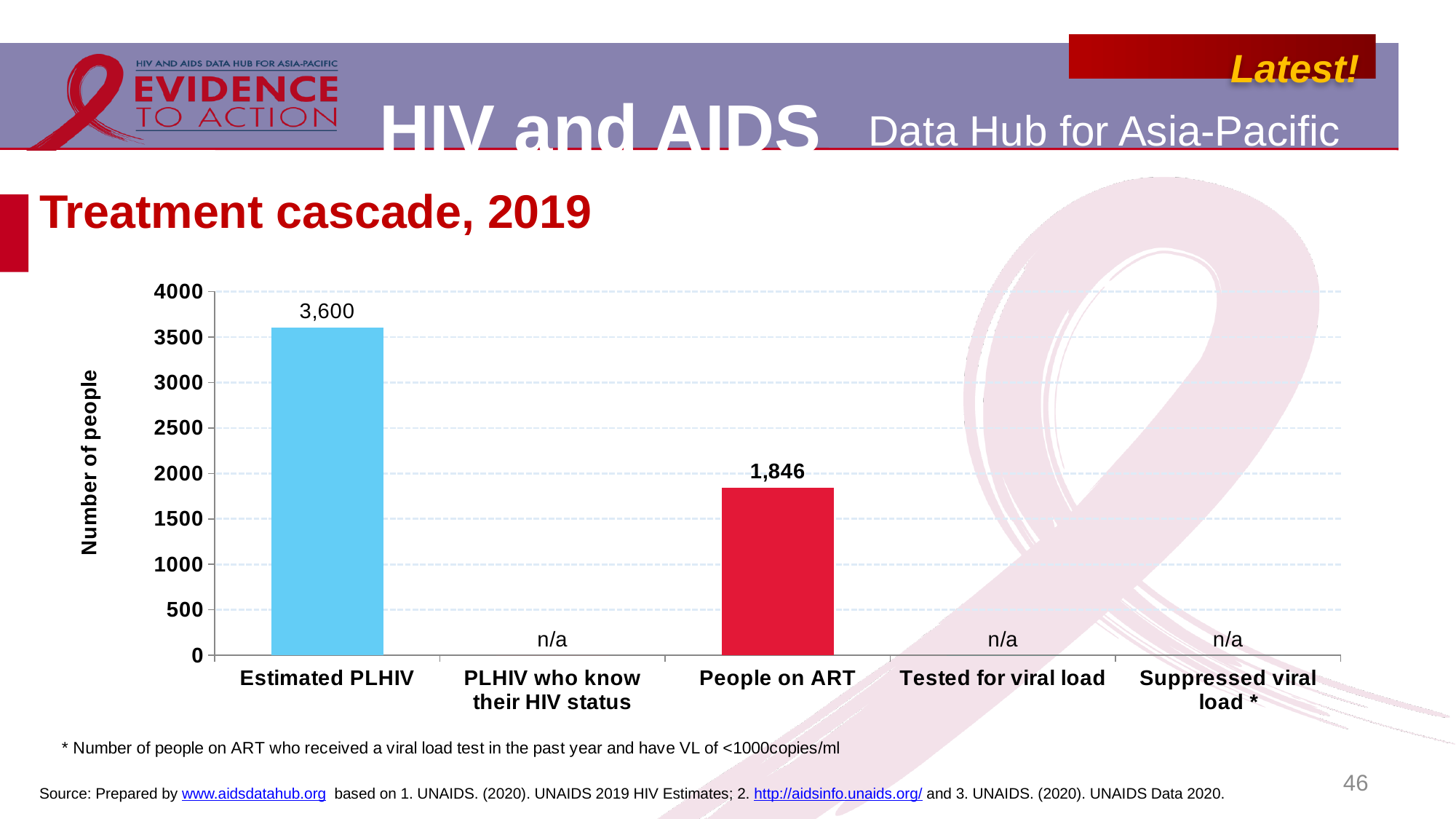
How many categories are shown on the x axis? 5 What is the value for Estimated PLHIV? 3,600 What is shown for Tested for viral load? n/a What is shown for PLHIV who know their HIV status? n/a What kind of chart is this? bar chart Is the value for People on ART greater or less than 2000? less What is the y-axis label? Number of people What is the title of the chart? Treatment cascade, 2019 What is the value for People on ART? 1,846 Which category has the highest value? Estimated PLHIV Which is larger, Estimated PLHIV or People on ART? Estimated PLHIV What is the difference between Estimated PLHIV and People on ART? 1,754